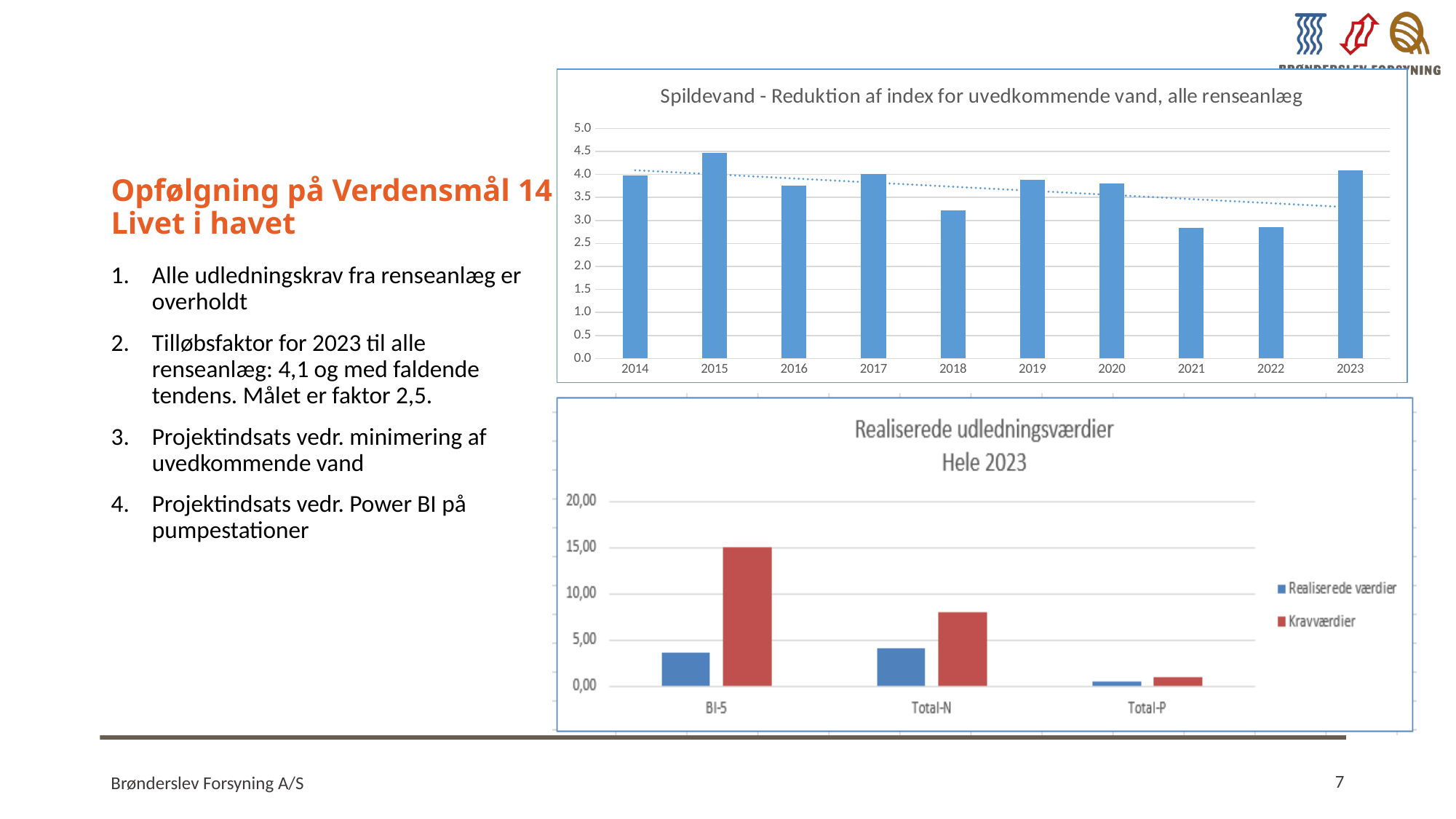
In the top chart 'Spildevand - Reduktion af index for uvedkommende vand, alle renseanlæg', is the value for 2018 greater or less than 3.5? less In the top chart 'Spildevand - Reduktion af index for uvedkommende vand, alle renseanlæg', is the value for 2021 greater or less than 3.0? less In the top chart 'Spildevand - Reduktion af index for uvedkommende vand, alle renseanlæg', which year has the highest bar? 2015 In the bottom chart 'Realiserede udledningsværdier Hele 2023', how many series does the legend list? 2 In the top chart 'Spildevand - Reduktion af index for uvedkommende vand, alle renseanlæg', how many years are shown on the x axis? 10 In the bottom chart 'Realiserede udledningsværdier Hele 2023', which is larger for Total-N, Realiserede værdier or Kravværdier? Kravværdier In the top chart 'Spildevand - Reduktion af index for uvedkommende vand, alle renseanlæg', is the value for 2023 greater or less than 4.0? greater In the bottom chart 'Realiserede udledningsværdier Hele 2023', what is the Kravværdier value for BI-5? 15,00 In the bottom chart 'Realiserede udledningsværdier Hele 2023', what colour are the Kravværdier bars? red What kind of chart is the top chart 'Spildevand - Reduktion af index for uvedkommende vand, alle renseanlæg'? bar chart In the bottom chart 'Realiserede udledningsværdier Hele 2023', which category has the highest Kravværdier bar? BI-5 In the top chart 'Spildevand - Reduktion af index for uvedkommende vand, alle renseanlæg', which is larger, the value for 2015 or the value for 2018? 2015